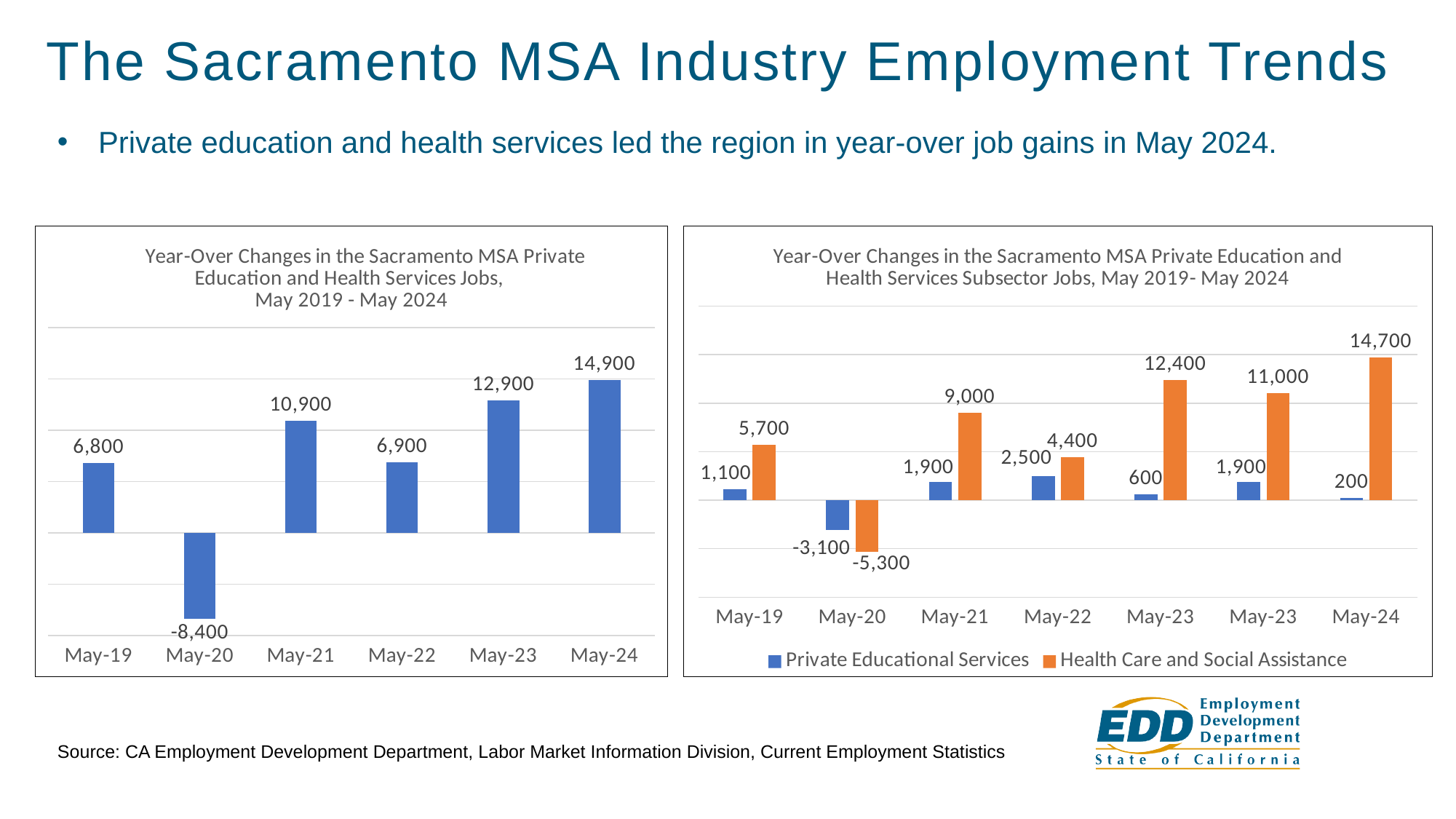
How many bars are plotted in the left chart? 6 In the left chart, which month has the lowest year-over change? May-20 In the left chart, which month has the highest year-over change? May-24 In the left chart, what is the value for May-20? -8,400 How many series does the legend of the right chart list? 2 In the right chart, what is the value for Health Care and Social Assistance in May-24? 14,700 In the left chart, which is larger, the value for May-21 or the value for May-22? May-21 In the right chart, what is the value for Private Educational Services in May-22? 2,500 In the left chart, what is the year-over change in private education and health services jobs for May-24? 14,900 In the left chart, what is the difference between the values for May-24 and May-23? 2,000 What type of chart is the right chart? Bar chart In the right chart, what is the difference between Health Care and Social Assistance and Private Educational Services in May-21? 7,100